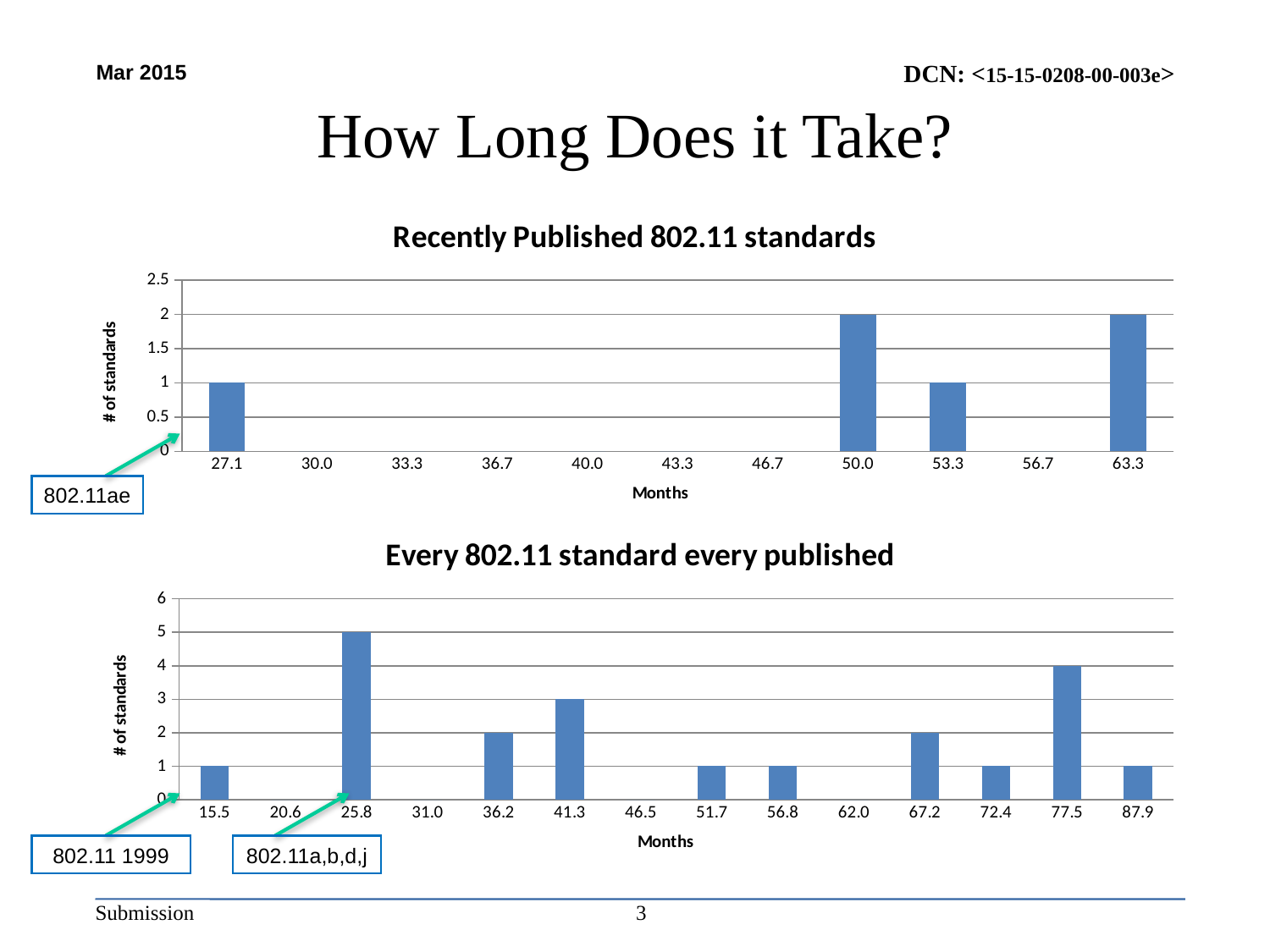
In the 'Every 802.11 standard every published' chart, what is the label of the y axis? # of standards In the 'Every 802.11 standard every published' chart, what is the value for 41.3 months? 3 What kind of chart is the 'Every 802.11 standard every published' chart? bar chart In the 'Recently Published 802.11 standards' chart, what is the value for 27.1 months? 1 In the 'Recently Published 802.11 standards' chart, what is the value for 50.0 months? 2 In the 'Recently Published 802.11 standards' chart, which is larger, the value for 53.3 months or the value for 63.3 months? 63.3 In the 'Every 802.11 standard every published' chart, which category has the highest value? 25.8 In the 'Every 802.11 standard every published' chart, what is the value for 77.5 months? 4 In the 'Every 802.11 standard every published' chart, which standard does the callout label the 25.8 months bar as? 802.11a,b,d,j In the 'Every 802.11 standard every published' chart, what is the difference between the values for 25.8 months and 36.2 months? 3 In the 'Every 802.11 standard every published' chart, how many categories are shown on the x axis? 14 In the 'Recently Published 802.11 standards' chart, how many categories are shown on the x axis? 11